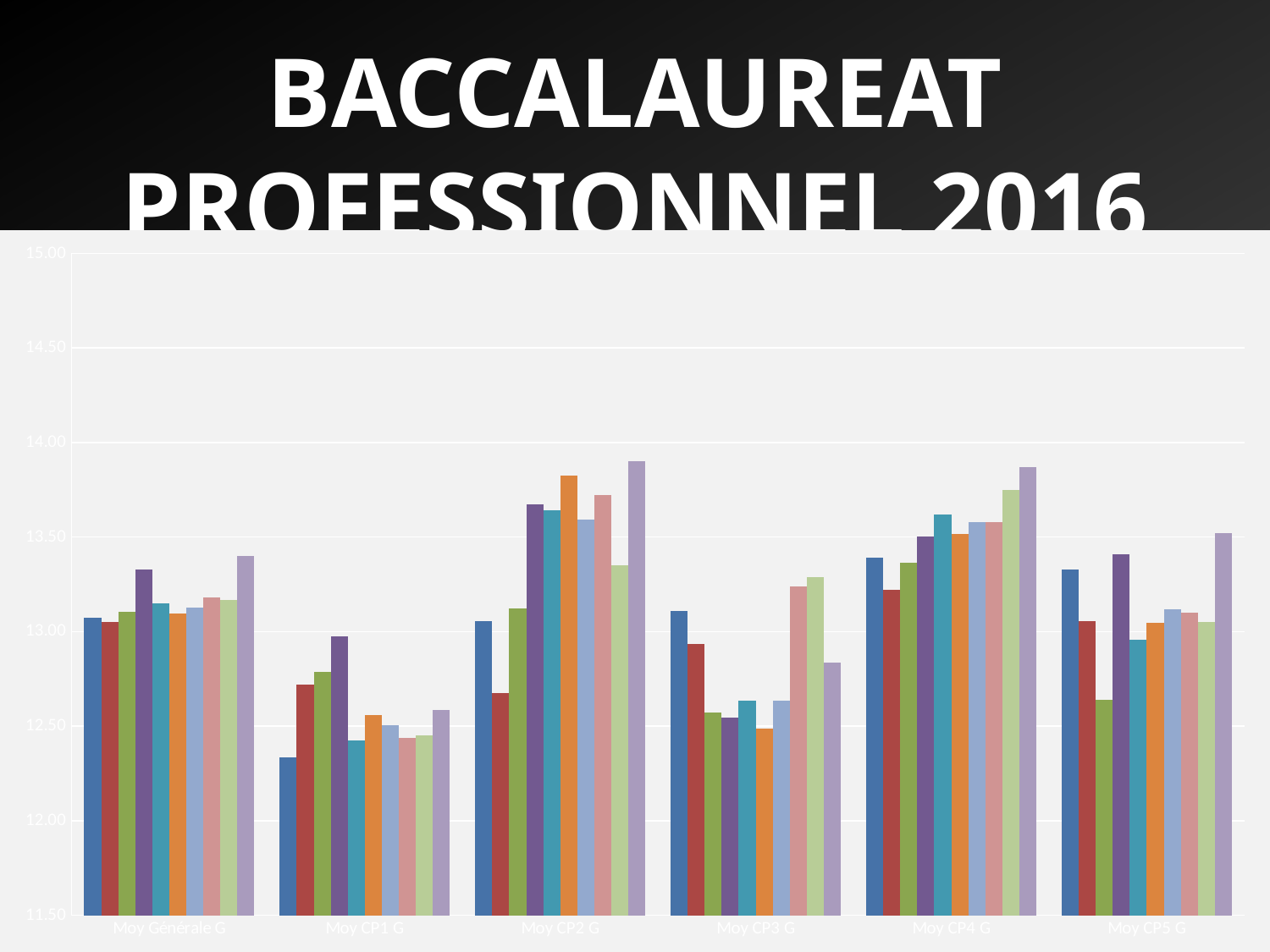
What is the title shown above the chart? BACCALAUREAT PROFESSIONNEL 2016 Which category contains the lowest bar in the whole chart? Moy CP1 G Is the value of the first (blue) bar in the Moy CP1 G group greater or less than 12.50? less Is the value of the third (green) bar in the Moy CP5 G group greater or less than 13.00? less Which is larger: the first (blue) bar in the Moy CP2 G group or the first (blue) bar in the Moy CP1 G group? Moy CP2 G What is the label of the first category on the x axis? Moy Générale G Is the value of the tallest bar in the Moy CP2 G group greater or less than 13.50? greater How many categories are shown along the x axis of the chart? 6 What kind of chart is shown on the slide? bar chart How many bars are plotted in each category group of the chart? 10